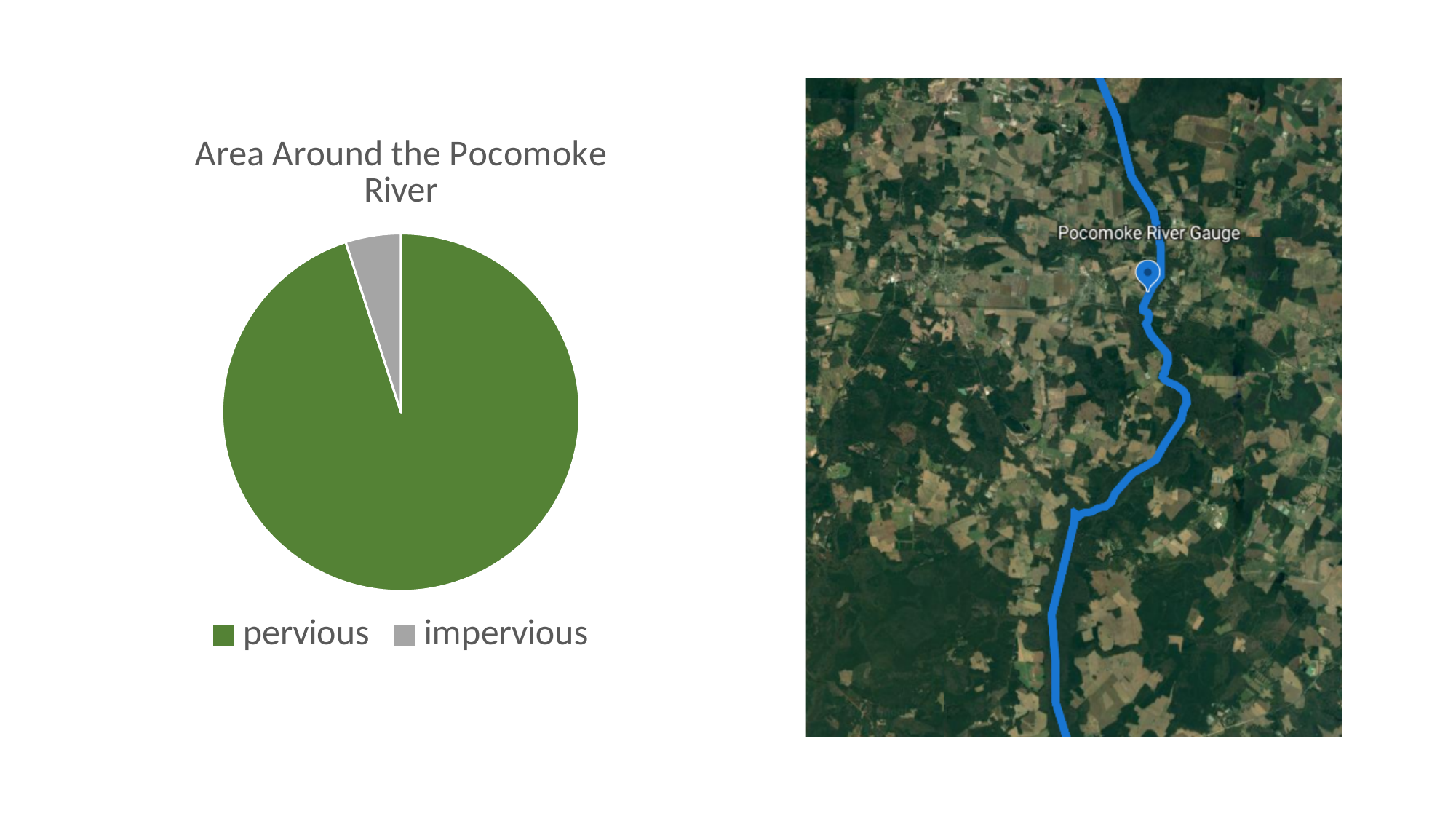
What colour represents the impervious category in the pie chart? grey What kind of chart is shown on the slide? pie chart What is the title of the pie chart? Area Around the Pocomoke River Which category has the largest slice in the pie chart? pervious Which category has the smallest slice in the pie chart? impervious Which slice is larger, pervious or impervious? pervious Which categories are listed in the legend of the pie chart? pervious, impervious How many categories does the pie chart show? 2